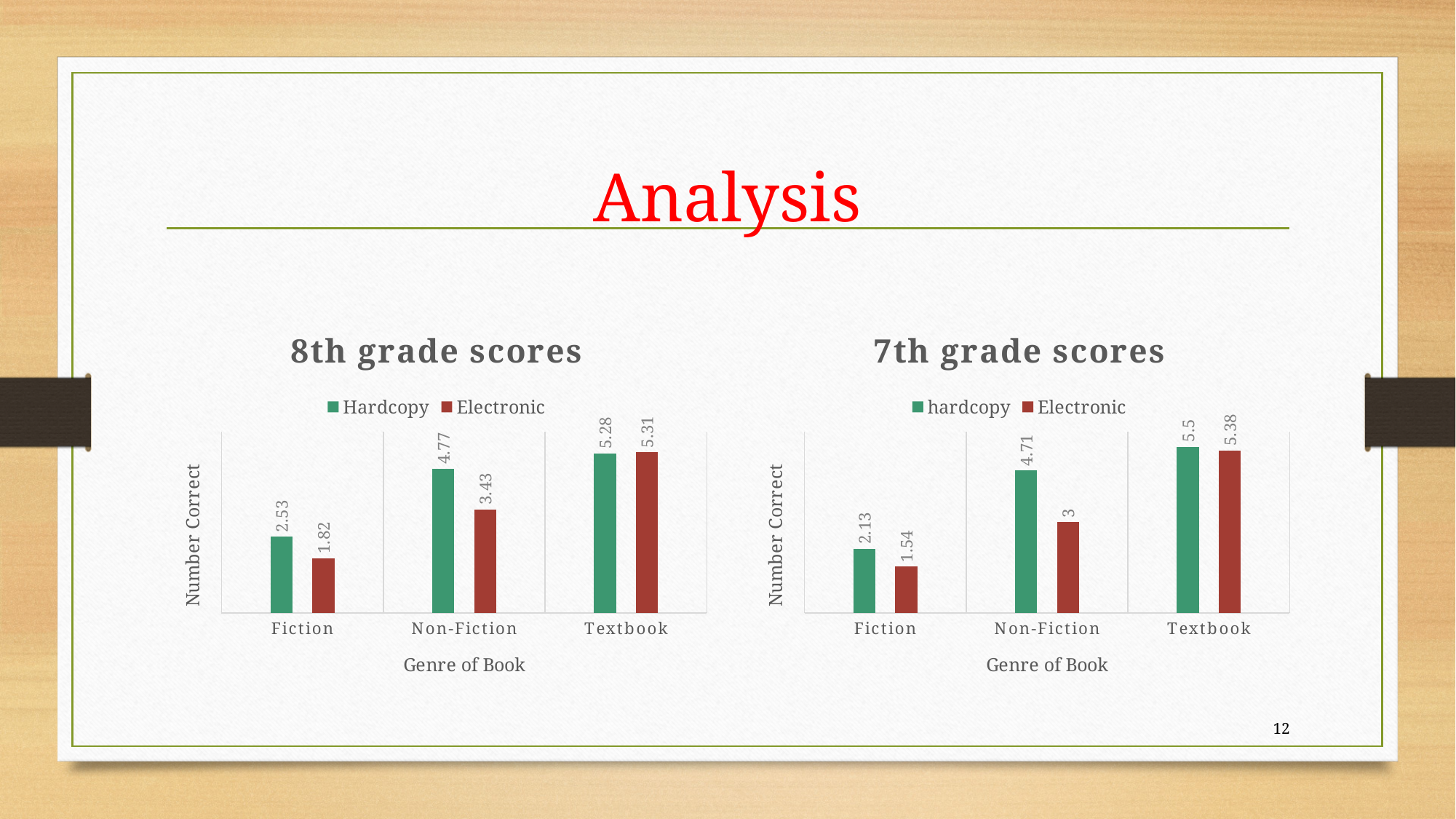
How many series does the legend of the '8th grade scores' chart list? 2 In the '7th grade scores' chart, what is the hardcopy value for Textbook? 5.5 What type of chart is the '7th grade scores' chart? Bar chart In the '7th grade scores' chart, what is the difference between the hardcopy and Electronic values for Fiction? 0.59 In the '7th grade scores' chart, what is the Electronic value for Non-Fiction? 3 In the '8th grade scores' chart, what is the Hardcopy value for Non-Fiction? 4.77 In the '8th grade scores' chart, what is the difference between the Hardcopy and Electronic values for Non-Fiction? 1.34 In the '8th grade scores' chart, which is larger for Fiction: Hardcopy or Electronic? Hardcopy In the '7th grade scores' chart, which genre has the highest hardcopy score? Textbook How many genre categories are shown in the '7th grade scores' chart? 3 In the '8th grade scores' chart, what is the Electronic value for Fiction? 1.82 In the '8th grade scores' chart, which genre has the lowest Electronic score? Fiction